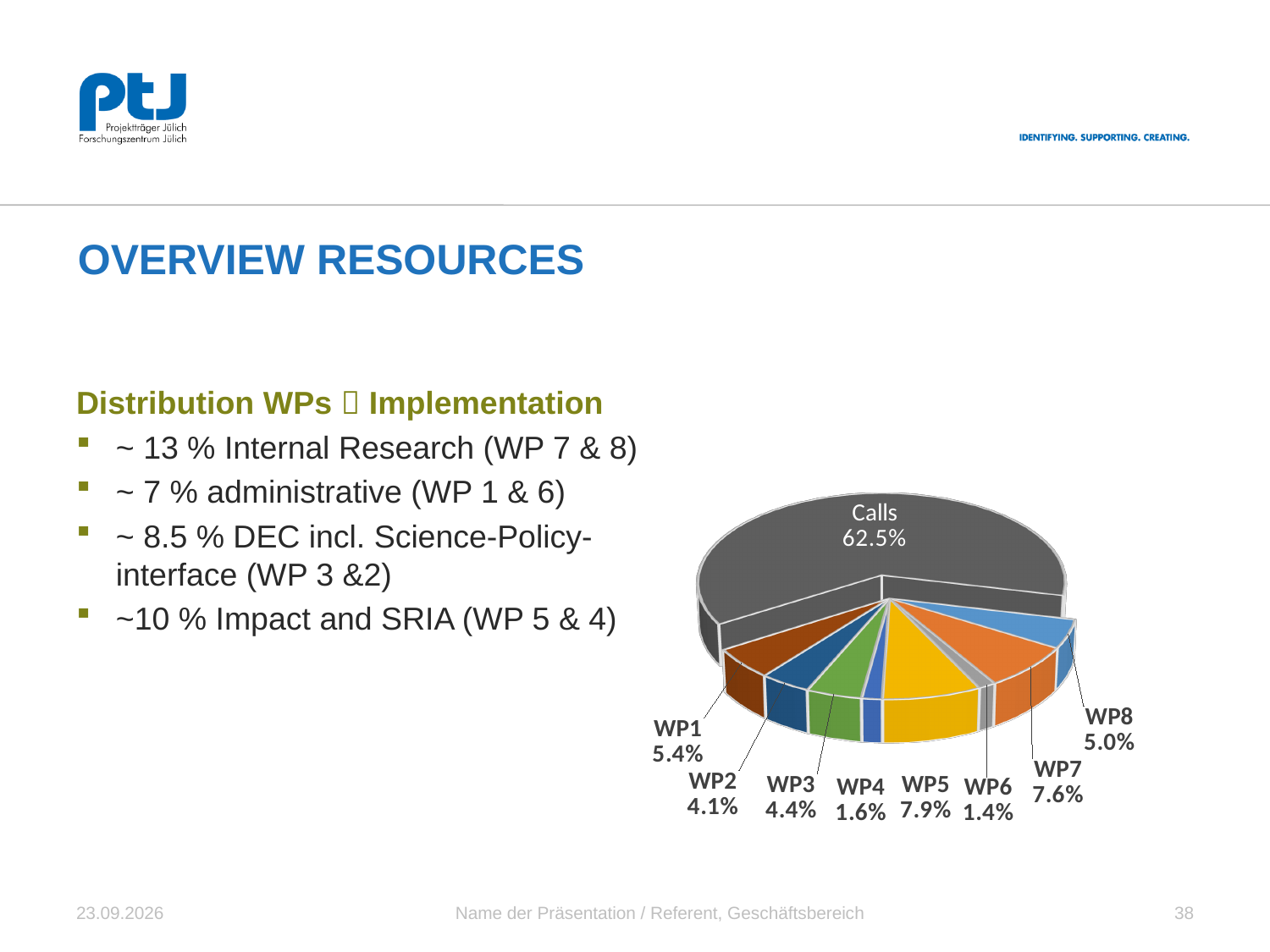
What is the value shown for WP8 in the pie chart? 5.0% What is the difference between the shares of WP7 and WP2? 3.5% What is the value shown for WP5 in the pie chart? 7.9% What is the value shown for WP4 in the pie chart? 1.6% Which of the work packages (WP1 to WP8) has the largest share? WP5 What type of chart is shown on the slide? Pie chart Which slice of the pie chart is the smallest? WP6 What is the combined share of WP7 and WP8? 12.6% Which has the larger share, WP1 or WP3? WP1 How many slices does the pie chart have? 9 What share of the pie does Calls account for? 62.5% Which slice of the pie chart is the largest? Calls